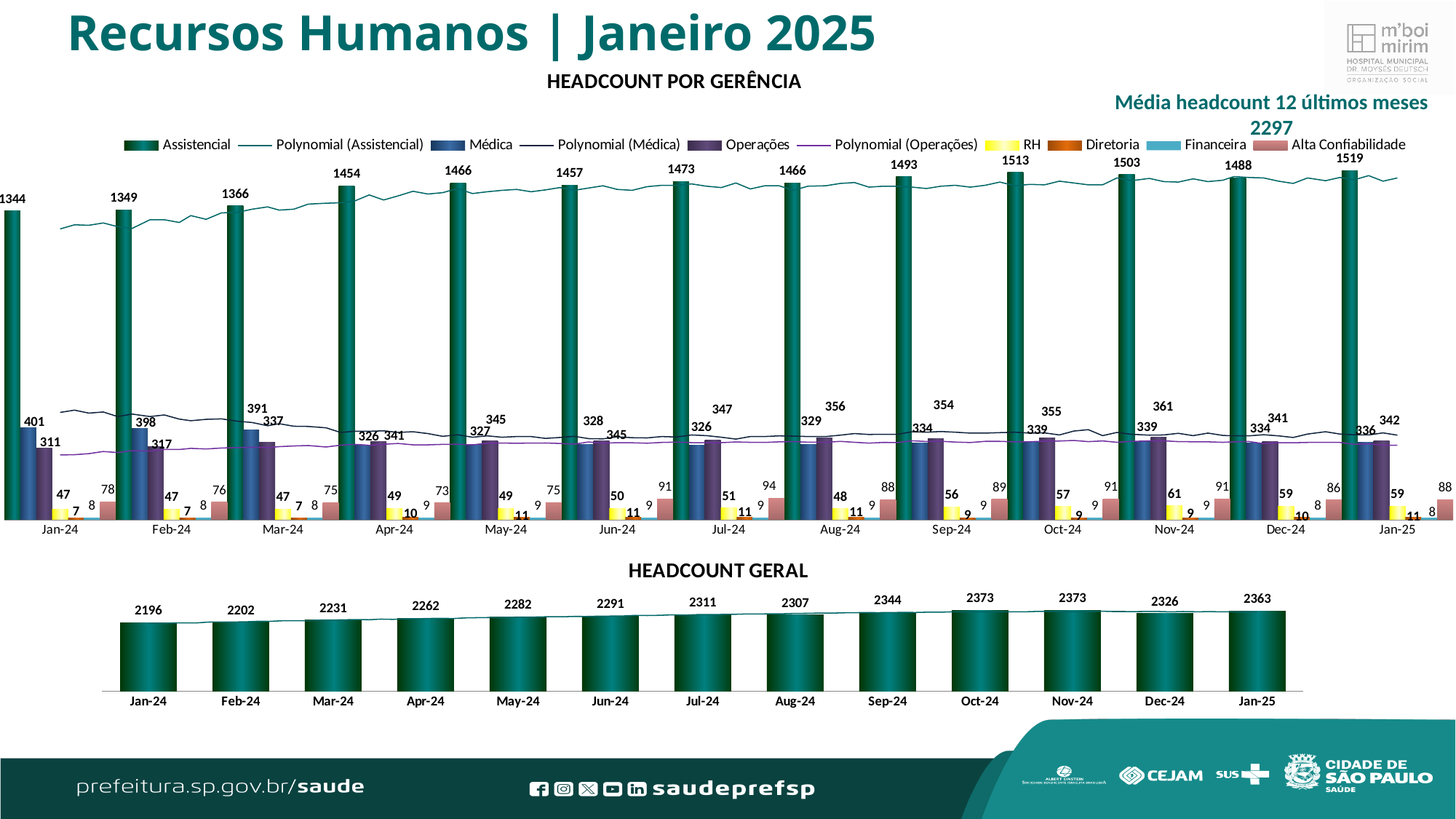
In the HEADCOUNT POR GERÊNCIA chart, what is the Assistencial value for Jan-25? 1519 In the HEADCOUNT POR GERÊNCIA chart, what is the Alta Confiabilidade value for Jul-24? 94 In the HEADCOUNT POR GERÊNCIA chart, which month has the highest Assistencial value? Jan-25 How many months are shown on the x axis of the HEADCOUNT GERAL chart? 13 In the HEADCOUNT POR GERÊNCIA chart, what is the Médica value for Jan-24? 401 In the HEADCOUNT POR GERÊNCIA chart, what is the difference between the Assistencial values for Jan-25 and Jan-24? 175 How many entries does the legend of the HEADCOUNT POR GERÊNCIA chart list? 10 In the HEADCOUNT GERAL chart, which month has the lowest value? Jan-24 In the HEADCOUNT GERAL chart, what is the value for Oct-24? 2373 In the HEADCOUNT POR GERÊNCIA chart, which is larger for Nov-24: the Médica value or the Operações value? Operações What type of chart is the HEADCOUNT GERAL chart? Bar chart In the HEADCOUNT POR GERÊNCIA chart, which month has the lowest Operações value? Jan-24